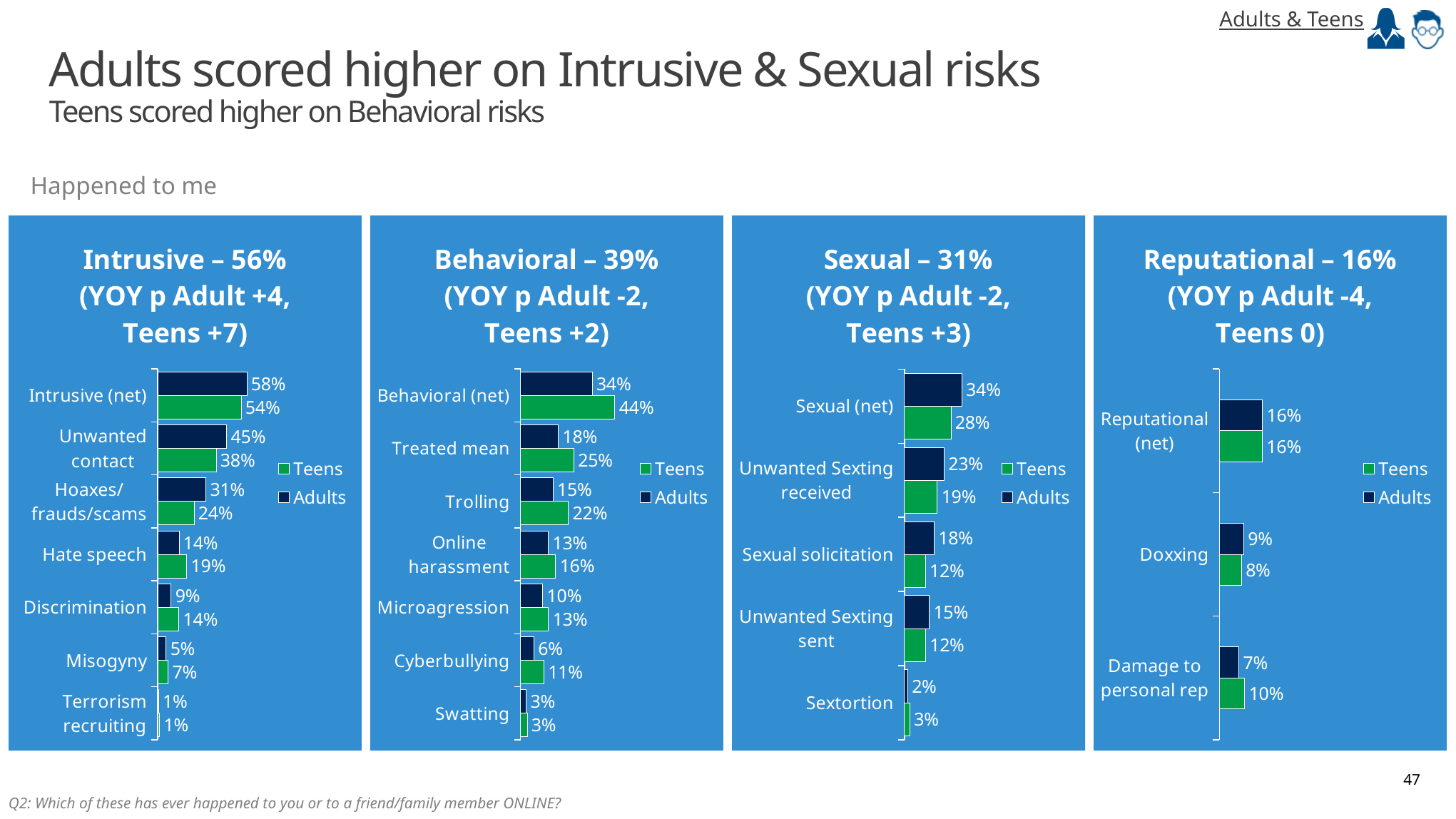
How many categories are shown in the Sexual chart? 5 In the Reputational chart, what is the Teens value for Damage to personal rep? 10% In the Behavioral chart, which category has the highest Teens value? Behavioral (net) In the Sexual chart, what is the difference between the Adults and Teens values for Sexual (net)? 6% How many series does the legend list in the Reputational chart? 2 In the Intrusive chart, what is the Adults value for Unwanted contact? 45% In the Reputational chart, which colour represents Teens? Green In the Behavioral chart, what is the Teens value for Treated mean? 25% What kind of chart is the Intrusive chart? Bar chart In the Intrusive chart, which category has the lowest Adults value? Terrorism recruiting In the Sexual chart, what is the Adults value for Sexual solicitation? 18% In the Behavioral chart, which is larger for Cyberbullying, the Adults value or the Teens value? Teens